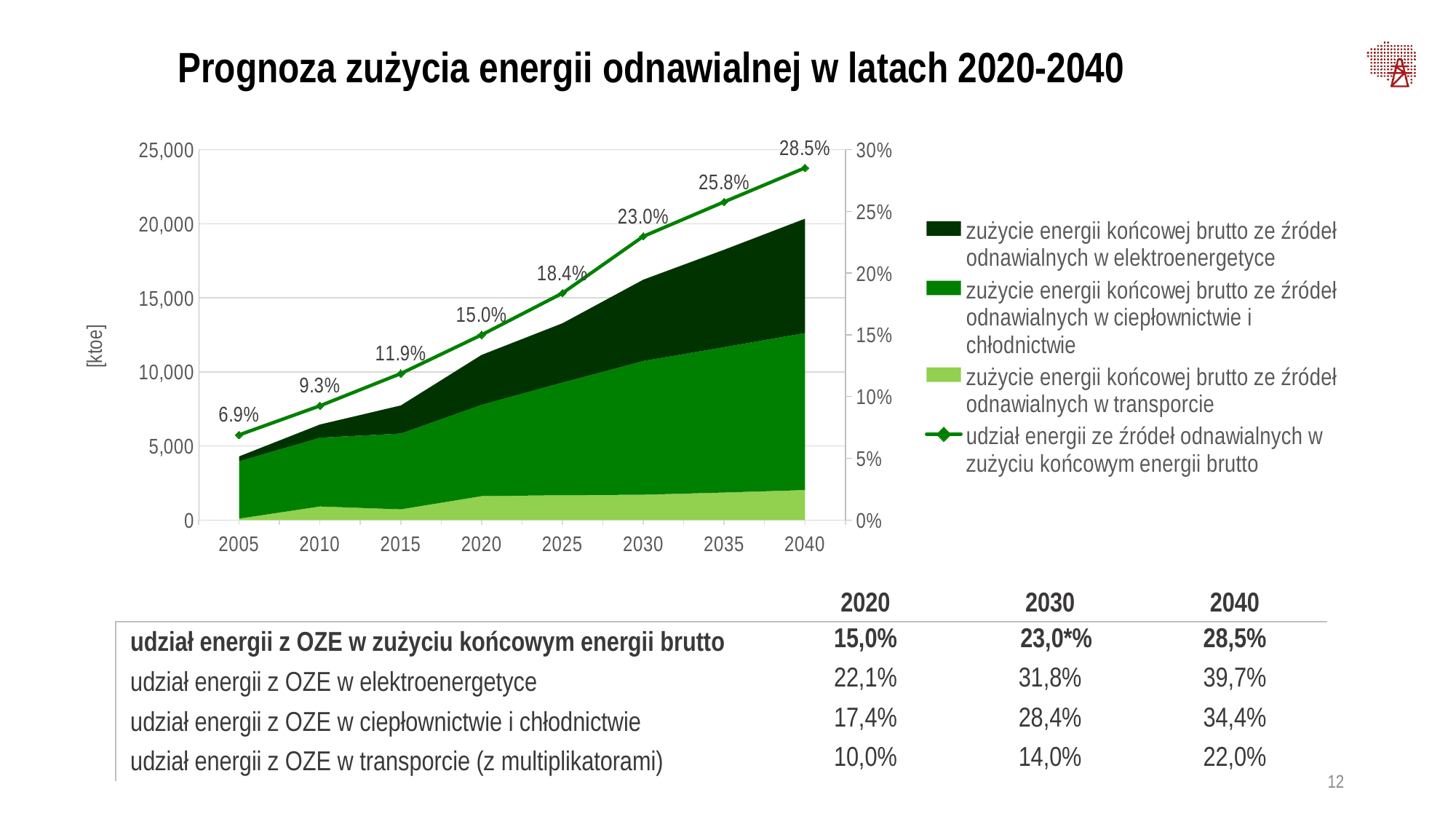
What is the share of energy from renewable sources in gross final energy consumption in 2035, as labelled on the line? 25.8% Which year has a higher labelled renewable energy share: 2015 or 2025? 2025 Is the total stacked renewable energy consumption (ktoe) in 2030 greater or less than 15,000? greater By how many percentage points does the renewable energy share increase from 2020 to 2040, according to the line labels? 13.5 percentage points How many series does the chart legend list? 4 In which year does the renewable energy share line have its lowest labelled value? 2005 What is the share of energy from renewable sources in gross final energy consumption in 2020, as labelled on the line? 15.0% Does the renewable energy share line rise or fall from 2005 to 2040? rises In which year does the renewable energy share line reach its highest labelled value? 2040 What is the share of energy from renewable sources in gross final energy consumption in 2005, as labelled on the line? 6.9% How many years are shown on the x axis of the chart? 8 Is the total stacked renewable energy consumption (ktoe) in 2005 greater or less than 5,000? less